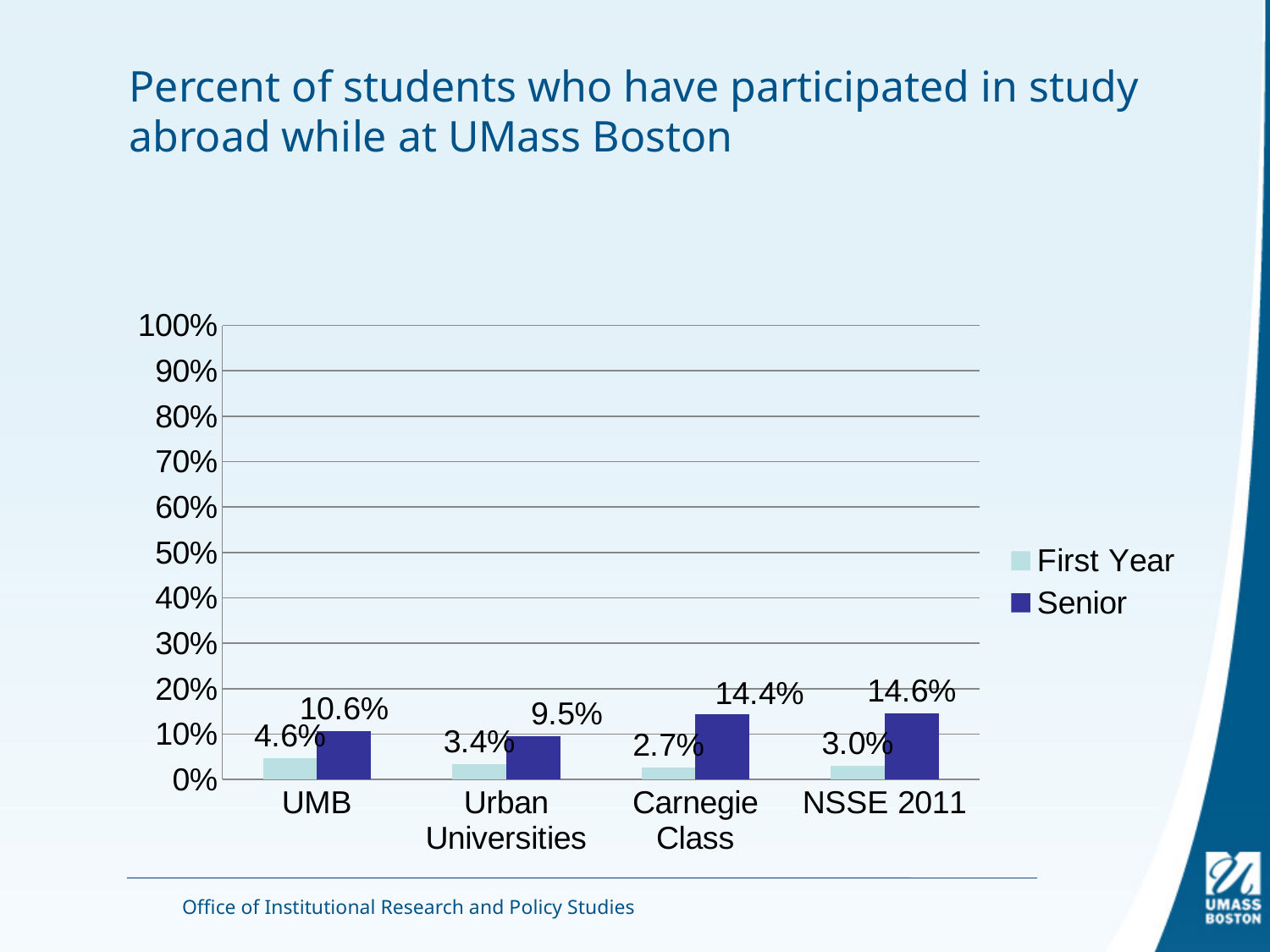
What is the First Year value for Carnegie Class? 2.7% How many series does the legend list? 2 What is the Senior value for Urban Universities? 9.5% Which is larger, the First Year value for UMB or the First Year value for NSSE 2011? UMB How many categories are shown on the x axis? 4 Is the Senior value for Carnegie Class greater or less than 10%? greater Which category has the highest Senior value? NSSE 2011 What is the Senior value for UMB? 10.6% Which category has the lowest First Year value? Carnegie Class What kind of chart is shown on the slide? bar chart What is the maximum value shown on the y axis? 100% What is the difference between the Senior and First Year values for UMB? 6.0%